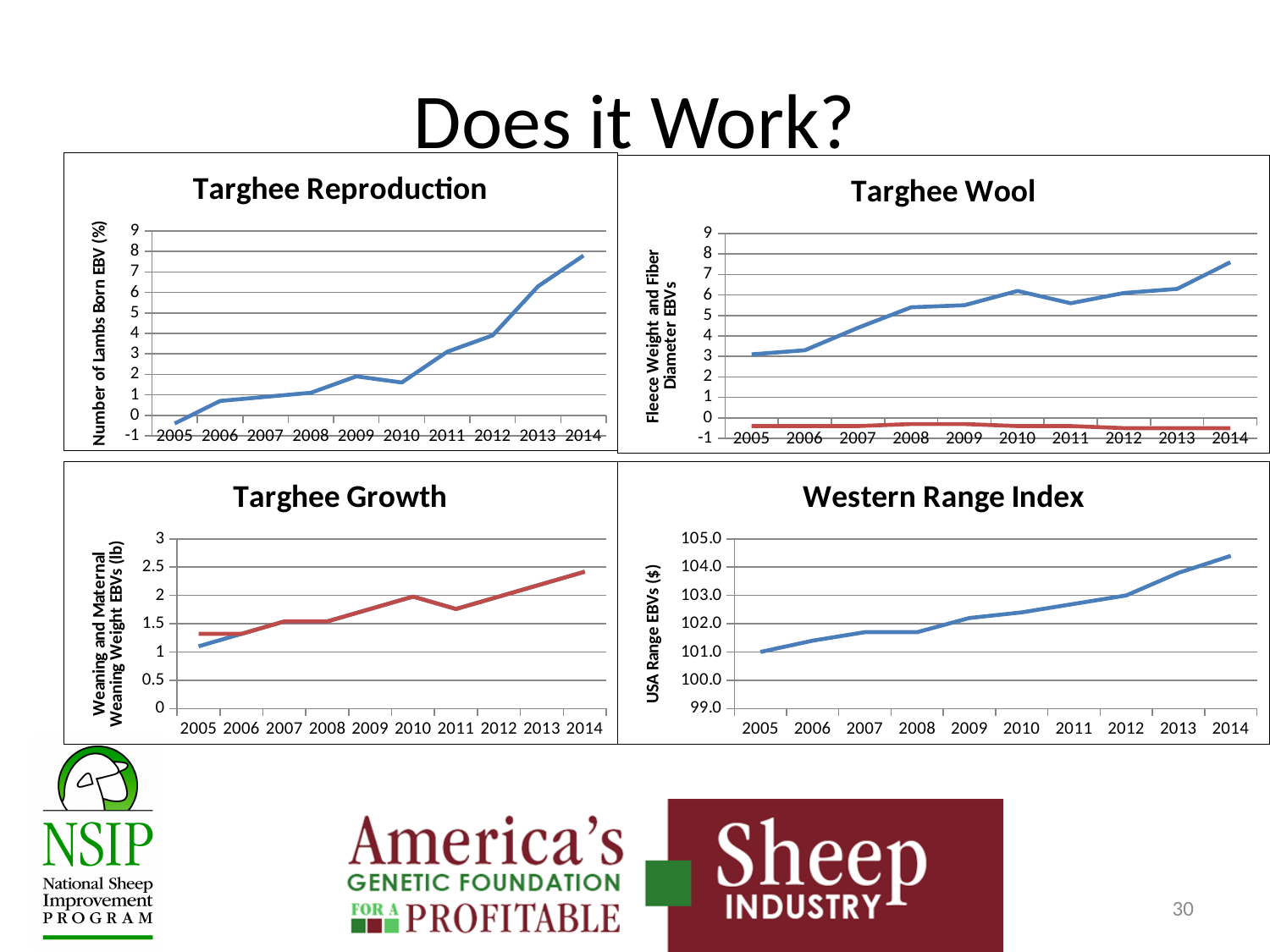
In the Targhee Wool chart, which year has the lowest value on the blue line? 2005 In the Targhee Reproduction chart, is the value for 2005 greater or less than 0? less How many years are shown on the x axis of the Western Range Index chart? 10 What is the y-axis label of the Western Range Index chart? USA Range EBVs ($) What kind of chart is the Targhee Reproduction chart? line chart In the Targhee Reproduction chart, do the values generally rise or fall from 2005 to 2014? rise In the Targhee Wool chart, is the value of the blue line for 2014 greater or less than 7? greater In the Targhee Reproduction chart, which year has the highest value? 2014 In the Western Range Index chart, is the value for 2005 greater or less than 102.0? less